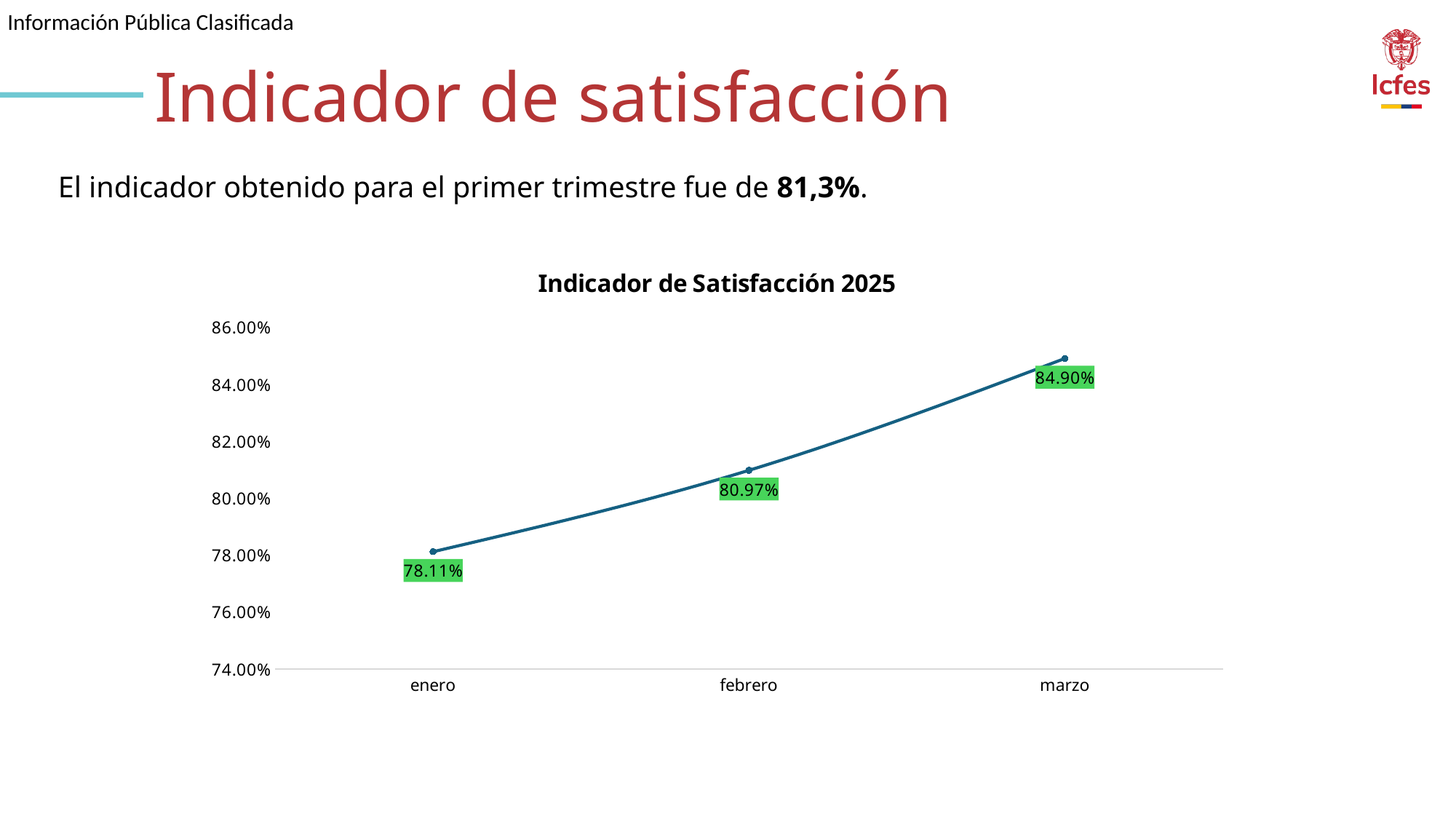
What is the difference between the values for febrero and enero? 2.86% What is the value for febrero? 80.97% Which month has the lowest value? enero Which is larger, the value for febrero or the value for marzo? marzo What is the value for enero? 78.11% How many months are plotted on the chart? 3 Is the value for enero greater or less than 80.00%? less What kind of chart is shown? line chart What is the value for marzo? 84.90% What is the difference between the values for marzo and enero? 6.79% Which month has the highest value? marzo Do the values rise or fall from enero to marzo? rise